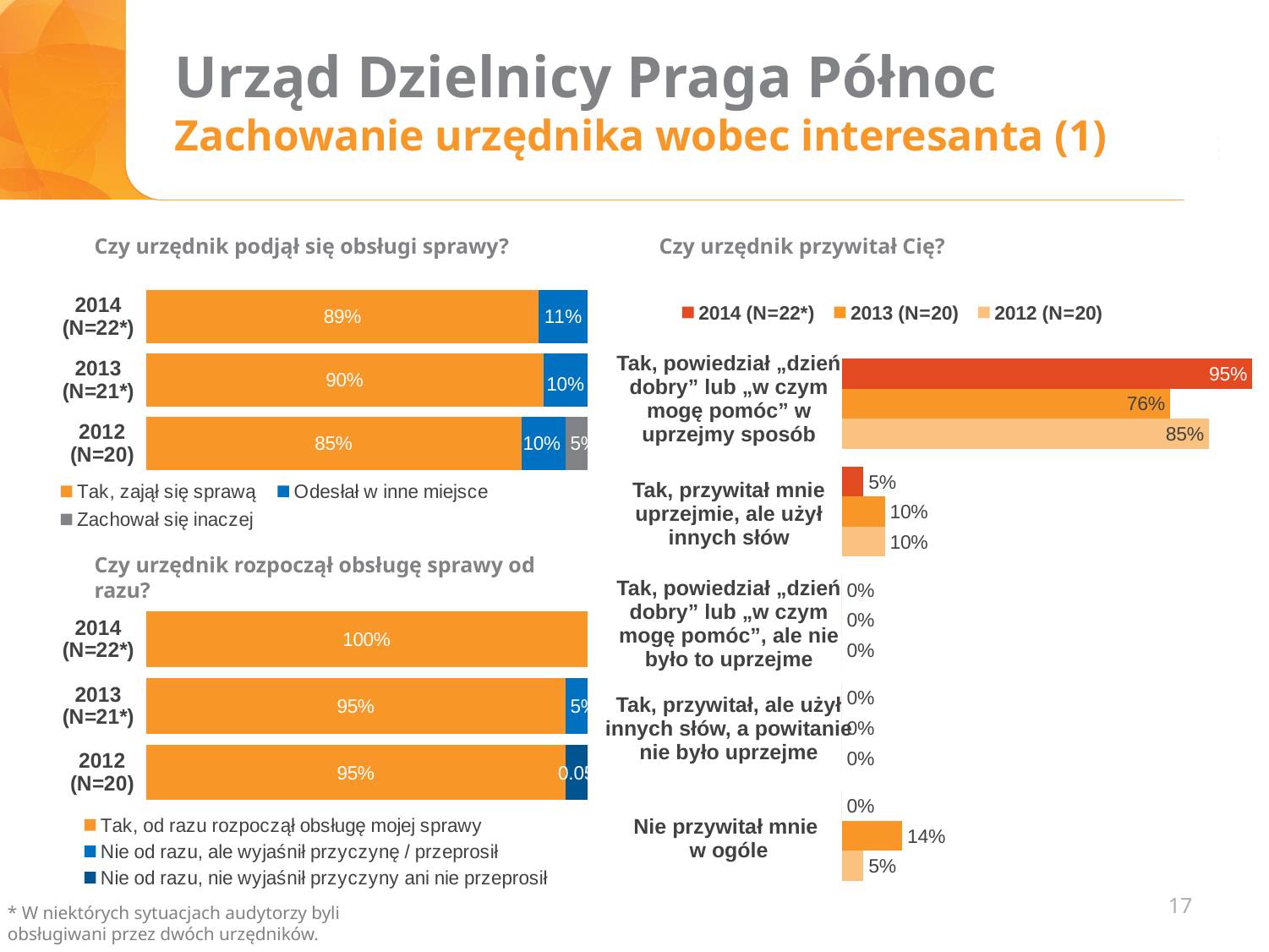
In the chart "Czy urzędnik przywitał Cię?", what is the difference between the 2014 (N=22*) and 2012 (N=20) values for "Tak, powiedział „dzień dobry” lub „w czym mogę pomóc” w uprzejmy sposób"? 10% In the chart "Czy urzędnik przywitał Cię?", what is the 2014 (N=22*) value for "Tak, powiedział „dzień dobry” lub „w czym mogę pomóc” w uprzejmy sposób"? 95% In the chart "Czy urzędnik rozpoczął obsługę sprawy od razu?", what is the difference between the "Tak, od razu rozpoczął obsługę mojej sprawy" values for 2014 (N=22*) and 2013 (N=21*)? 5% In the chart "Czy urzędnik przywitał Cię?", which series has the lowest value for "Tak, powiedział „dzień dobry” lub „w czym mogę pomóc” w uprzejmy sposób"? 2013 (N=20) In the chart "Czy urzędnik podjął się obsługi sprawy?", how many series does the legend list? 3 In the chart "Czy urzędnik przywitał Cię?", what is the 2013 (N=20) value for "Nie przywitał mnie w ogóle"? 14% How many categories are shown in the chart "Czy urzędnik przywitał Cię?"? 5 In the chart "Czy urzędnik podjął się obsługi sprawy?", what percentage for 2014 (N=22*) is shown for "Tak, zajął się sprawą"? 89% In the chart "Czy urzędnik rozpoczął obsługę sprawy od razu?", what is the value of "Tak, od razu rozpoczął obsługę mojej sprawy" for 2014 (N=22*)? 100% What type of chart is "Czy urzędnik rozpoczął obsługę sprawy od razu?"? Stacked bar chart In the chart "Czy urzędnik podjął się obsługi sprawy?", what is the value of "Zachował się inaczej" for 2012 (N=20)? 5% In the chart "Czy urzędnik podjął się obsługi sprawy?", which year has the highest share of "Tak, zajął się sprawą"? 2013 (N=21*)